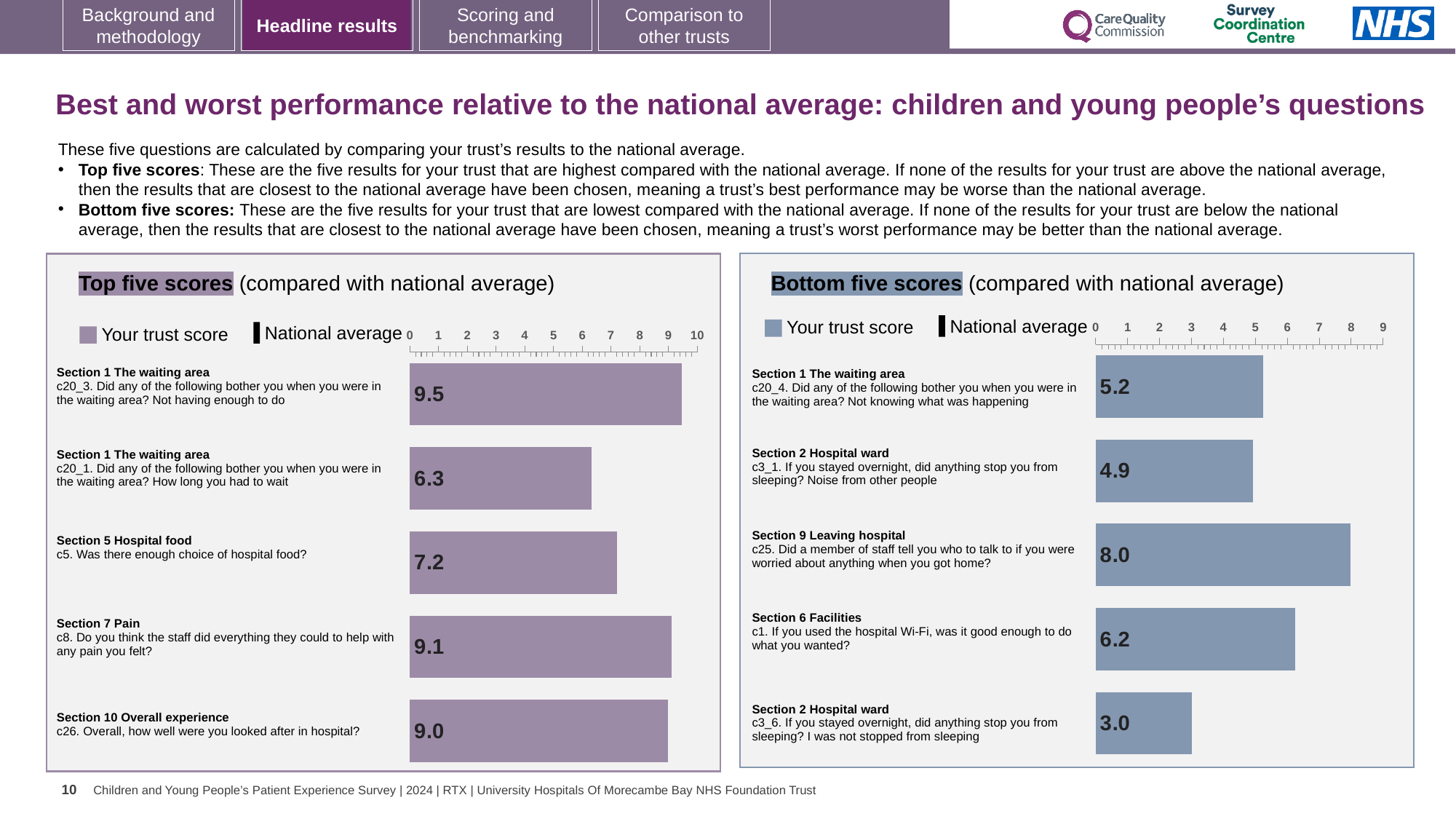
How many entries does the legend of the Bottom five scores chart list? 2 In the Top five scores chart, what is the difference between the scores for c8 (Pain) and c26 (Overall experience)? 0.1 In the Bottom five scores chart, is the score for c20_4 (Not knowing what was happening) larger or smaller than the score for c1 (Wi-Fi)? smaller In the Top five scores chart, which question has the lowest trust score? c20_1. How long you had to wait In the Top five scores chart, how many questions are shown? 5 In the Bottom five scores chart, which question has the highest trust score? c25. Did a member of staff tell you who to talk to if you were worried about anything when you got home? In the Bottom five scores chart, which question has the lowest trust score? c3_6. I was not stopped from sleeping In the Bottom five scores chart, what is the trust score for c25 (Did a member of staff tell you who to talk to if you were worried)? 8.0 In the Bottom five scores chart, what is the difference between the scores for c1 (Wi-Fi) and c3_1 (Noise from other people)? 1.3 In the Top five scores chart, what is the trust score for c5 (Was there enough choice of hospital food?)? 7.2 What type of chart is used in the Top five scores panel? bar chart In the Top five scores chart, what is the trust score for c20_3 (Not having enough to do in the waiting area)? 9.5